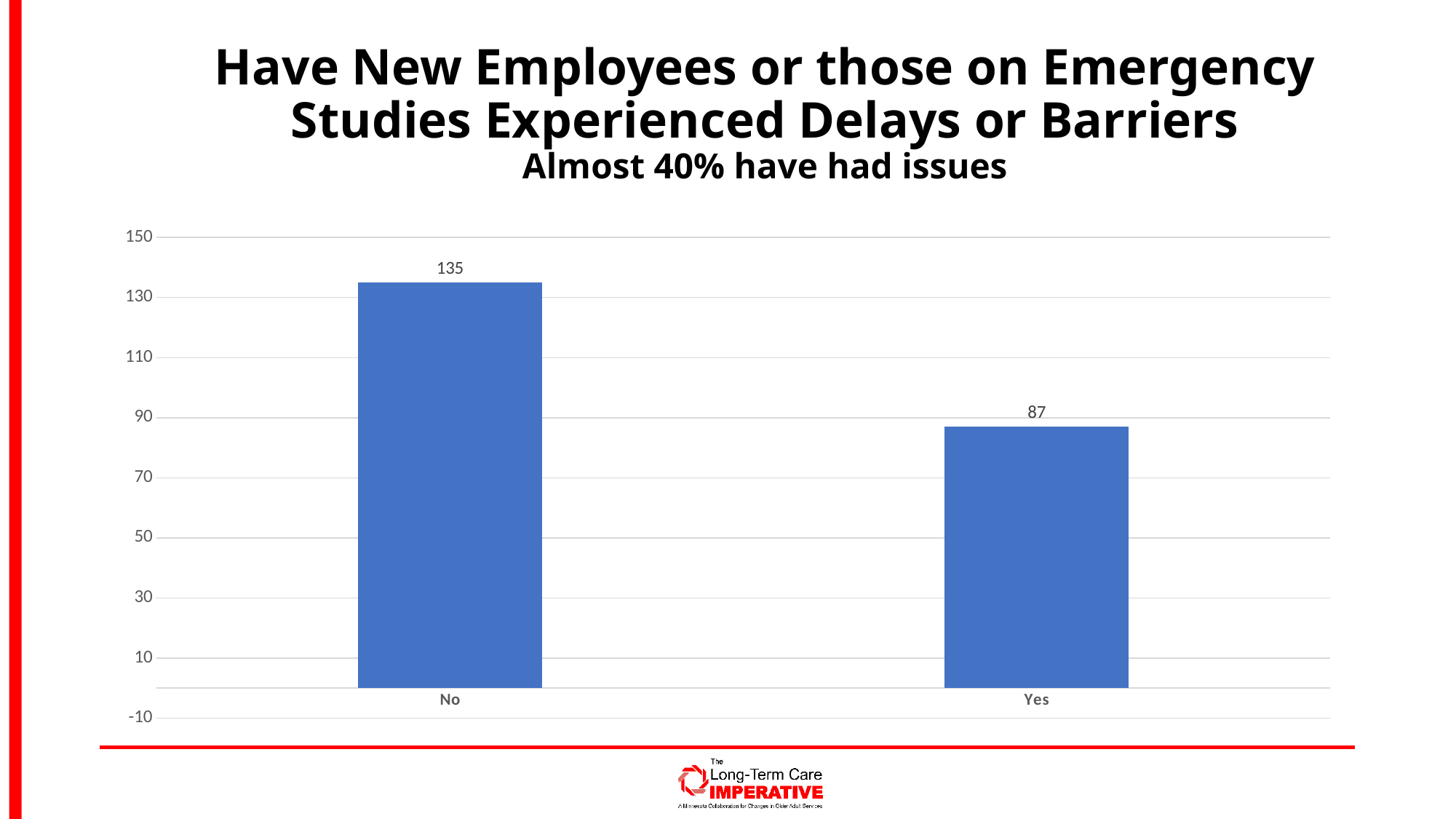
Which category has the highest value? No Is the value for "No" greater or less than 130? greater Is the value for "Yes" greater or less than 90? less What is the difference between the values for "No" and "Yes"? 48 Which category has the lowest value? Yes Which is larger, the value for "No" or the value for "Yes"? No How many categories are shown on the chart? 2 What is the value for the "Yes" category? 87 What kind of chart is shown on the slide? bar chart What is the value for the "No" category? 135 What is the subtitle shown below the chart title? Almost 40% have had issues What is the total of the two bars on the chart? 222